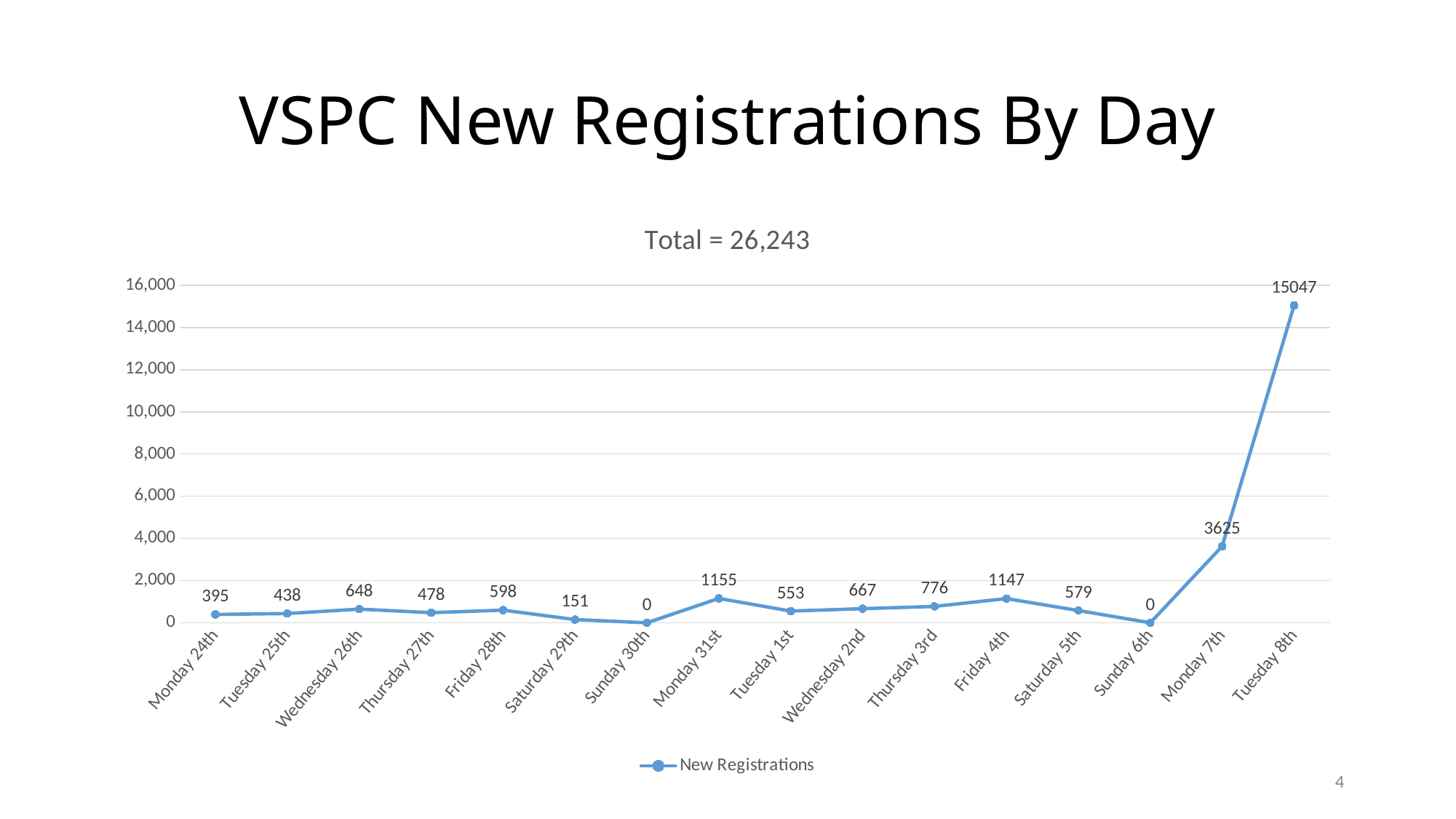
What is the value for Friday 4th? 1147 What is the chart's subtitle text above the plot area? Total = 26,243 What is the value for Monday 7th? 3625 Which day has the highest number of new registrations? Tuesday 8th What is the name of the series in the legend? New Registrations How many days are plotted on the x axis? 16 What kind of chart is shown? line chart Which is larger, the value for Monday 31st or the value for Thursday 3rd? Monday 31st What is the value for Saturday 29th? 151 How many series does the legend list? 1 What is the difference between the values for Tuesday 8th and Monday 7th? 11422 Is the value for Monday 7th greater or less than 4,000? less